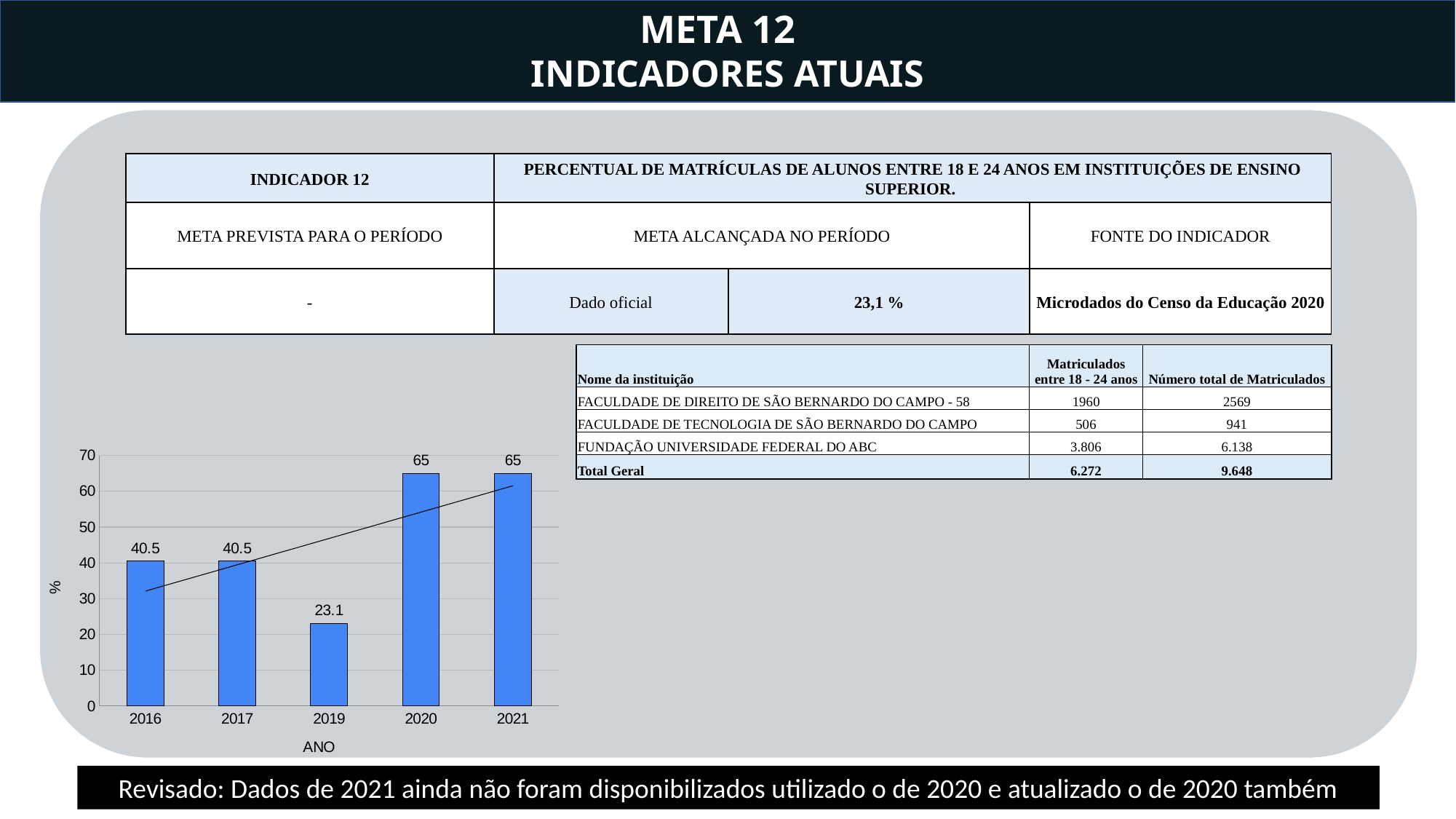
What type of chart is shown on the slide? bar chart Which is larger in the bar chart, the value for 2017 or the value for 2019? 2017 How many years (bars) are shown in the bar chart? 5 What is the label of the x axis of the bar chart? ANO What is the difference between the values for 2016 and 2019 in the bar chart? 17.4 What is the difference between the values for 2020 and 2019 in the bar chart? 41.9 What is the label of the y axis of the bar chart? % Is the value for 2021 in the bar chart greater or less than 60? greater What is the value for 2016 in the bar chart? 40.5 What is the value for 2020 in the bar chart? 65 Which year has the lowest value in the bar chart? 2019 What is the value for 2019 in the bar chart? 23.1